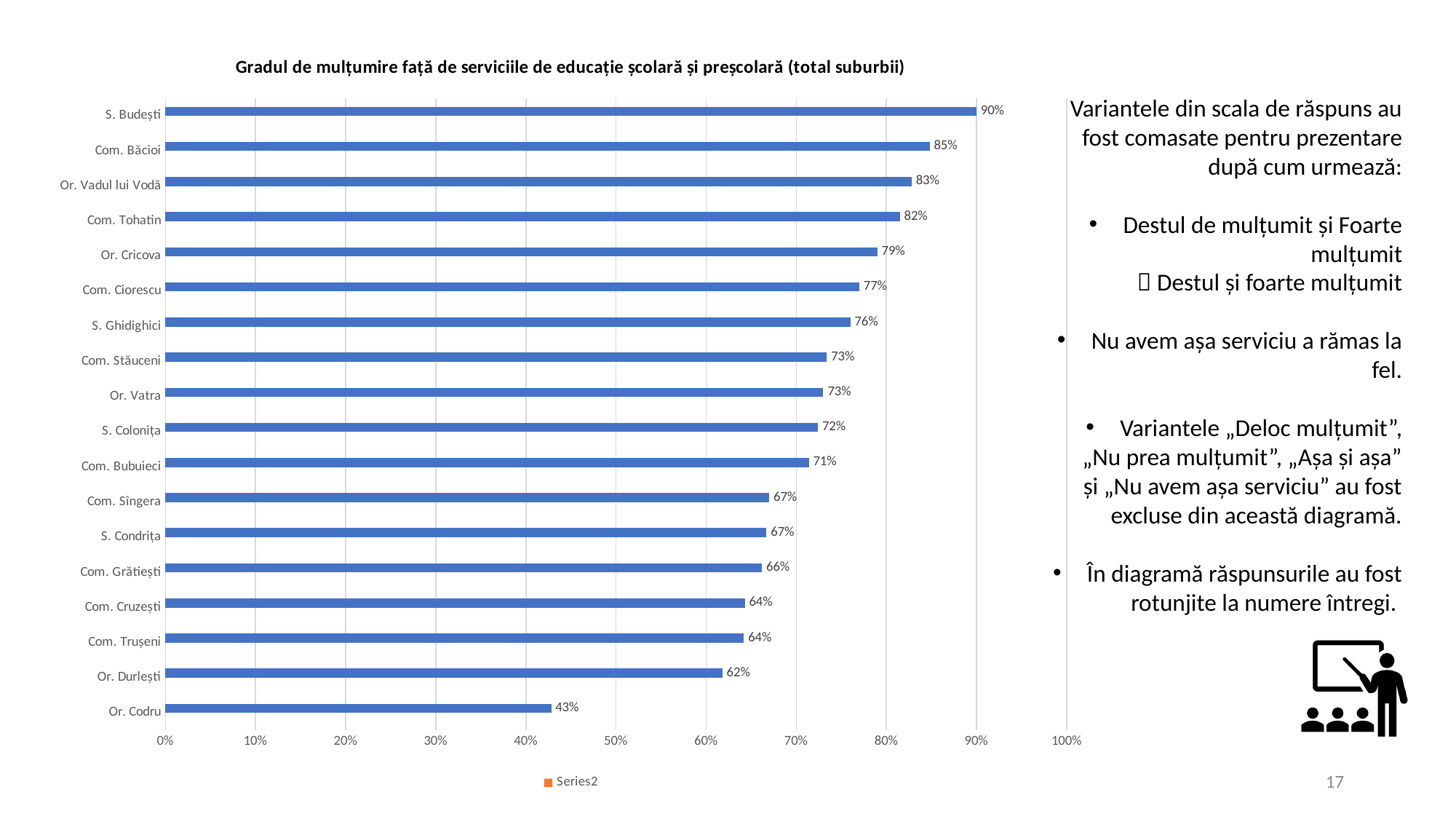
What is the value for Com. Ciorescu? 77% Which is larger, the value for Or. Cricova or the value for S. Colonița? Or. Cricova What is the value for Com. Grătiești? 66% How many series does the legend list? 1 How many categories are shown in the chart? 18 What is the value for Or. Codru? 43% Which category has the highest value? S. Budești What kind of chart is shown on the slide? Bar chart What is the legend entry shown below the chart? Series2 What is the difference between the values for Com. Băcioi and Or. Durlești? 23% Which category has the lowest value? Or. Codru What is the value for S. Budești? 90%